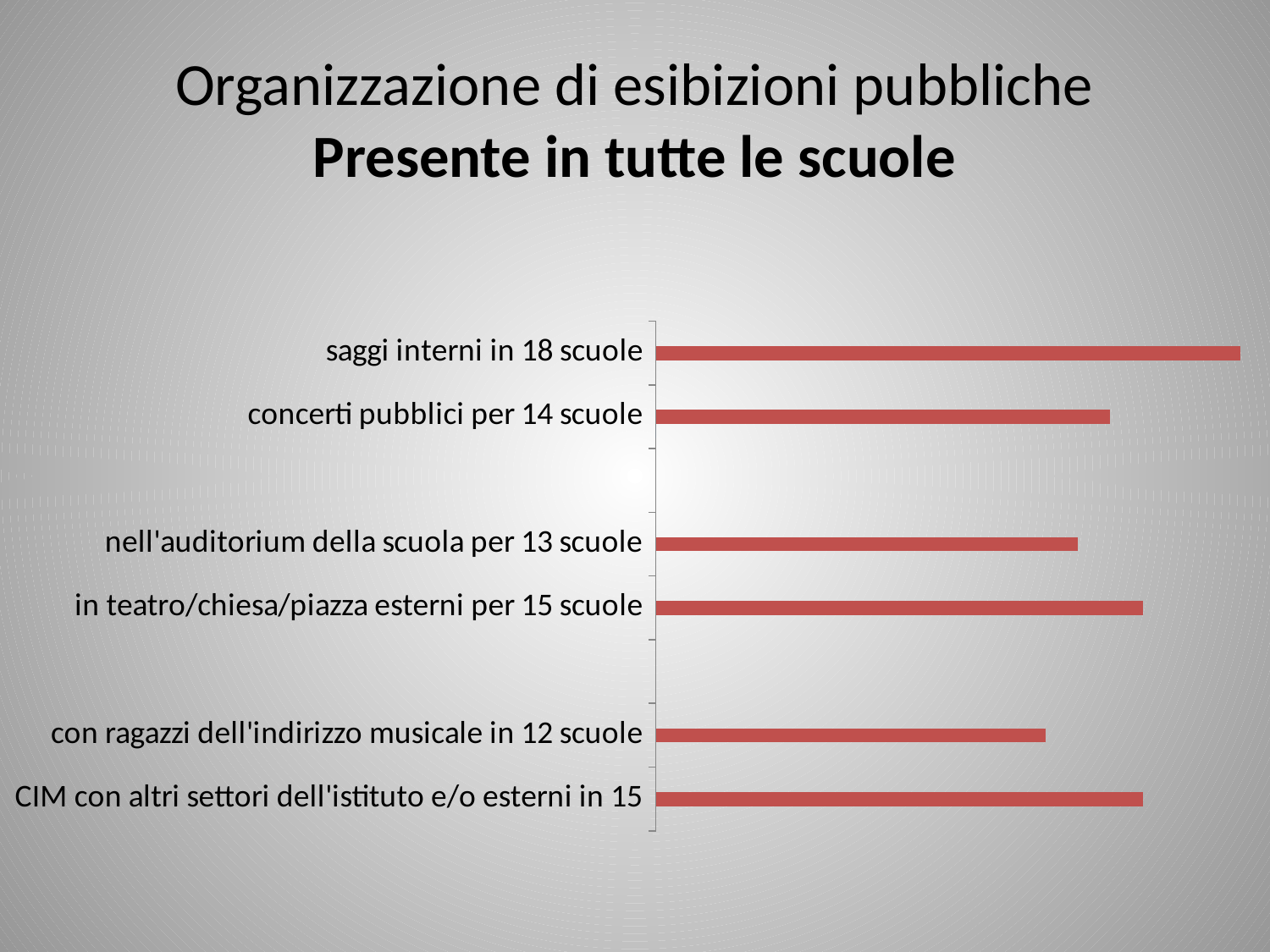
What is the difference between the number of schools for 'saggi interni' (18) and for 'concerti pubblici' (14)? 4 According to the category label, in how many schools are 'saggi interni' held? 18 How many bars are plotted in the chart? 6 According to the category label, for how many schools are concerts held 'in teatro/chiesa/piazza esterni'? 15 Which bar is longer: 'in teatro/chiesa/piazza esterni' or 'con ragazzi dell'indirizzo musicale'? in teatro/chiesa/piazza esterni Which bar is longer: 'saggi interni' or 'concerti pubblici'? saggi interni Which category has the shortest bar in the chart? con ragazzi dell'indirizzo musicale in 12 scuole Which category has the longest bar in the chart? saggi interni in 18 scuole According to the category label, for how many schools are concerts held 'nell'auditorium della scuola'? 13 What kind of chart is shown on the slide? bar chart According to the category label, for how many schools are 'concerti pubblici' organised? 14 What is the title shown above the chart on the slide? Organizzazione di esibizioni pubbliche Presente in tutte le scuole